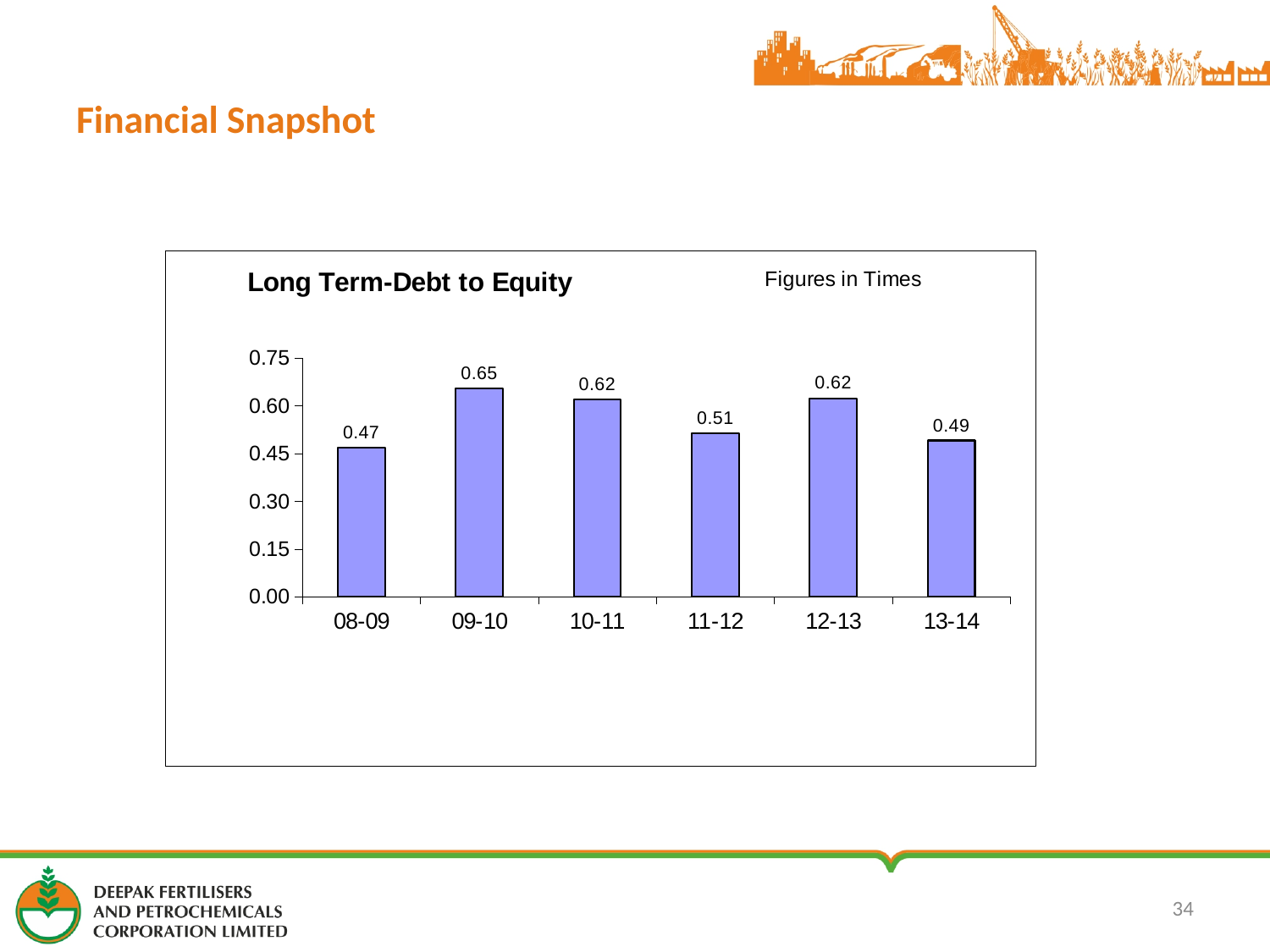
What is the Long Term-Debt to Equity value for 13-14? 0.49 Which is larger, the Long Term-Debt to Equity value for 10-11 or for 11-12? 10-11 Does the Long Term-Debt to Equity value rise or fall from 12-13 to 13-14? Fall Is the Long Term-Debt to Equity value for 12-13 greater or less than 0.60? greater What is the Long Term-Debt to Equity value for 08-09? 0.47 In what unit are the figures on the Long Term-Debt to Equity chart expressed? Times How many years are shown on the Long Term-Debt to Equity chart? 6 What kind of chart is used to show Long Term-Debt to Equity? Bar chart What is the Long Term-Debt to Equity value for 11-12? 0.51 Which year has the highest Long Term-Debt to Equity value? 09-10 Which year has the lowest Long Term-Debt to Equity value? 08-09 What is the difference between the Long Term-Debt to Equity values for 09-10 and 13-14? 0.16